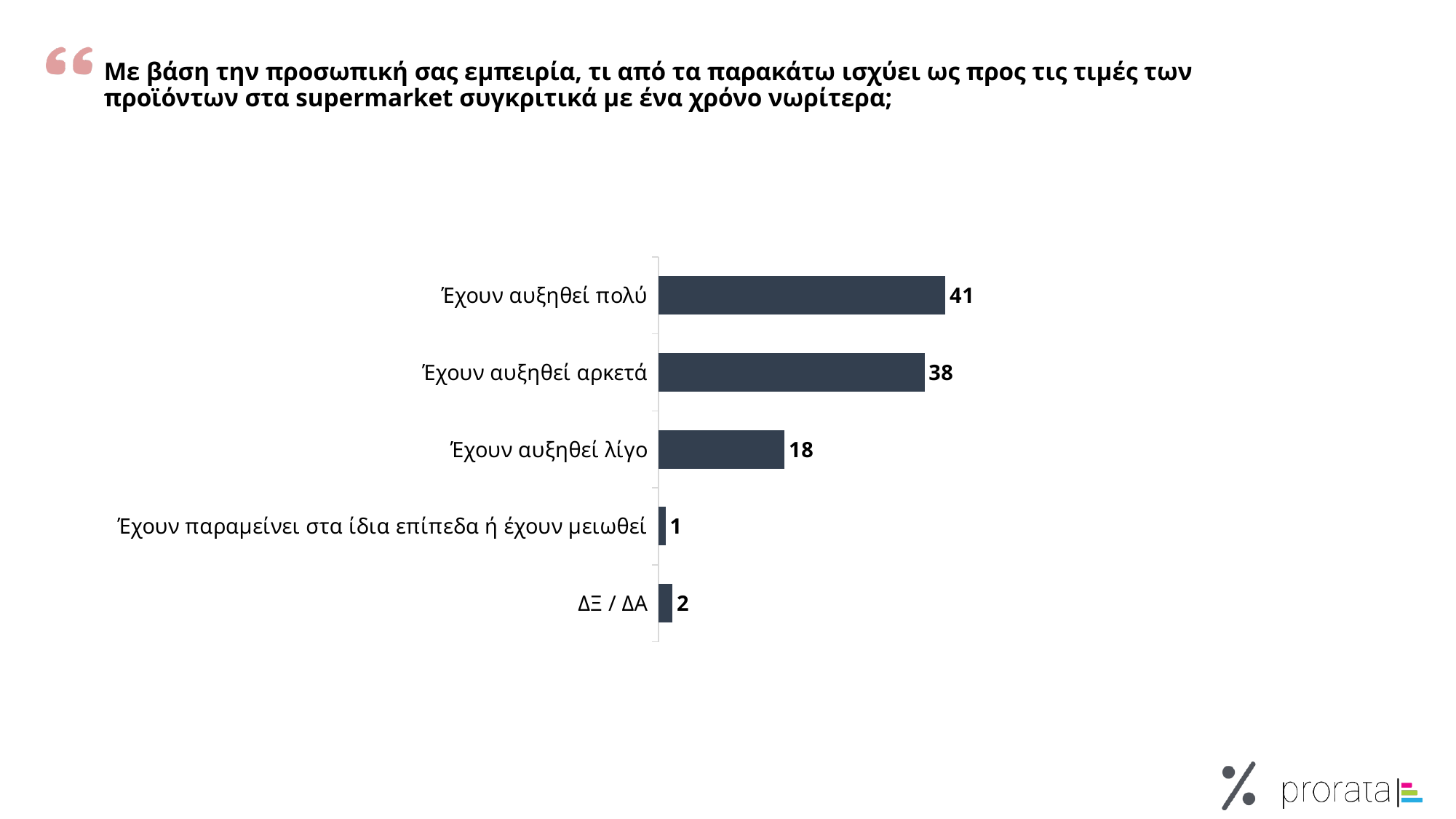
Which category has the lowest value? Έχουν παραμείνει στα ίδια επίπεδα ή έχουν μειωθεί Which category has the highest value? Έχουν αυξηθεί πολύ What is the value for "Έχουν αυξηθεί αρκετά"? 38 What is the difference between the values for "Έχουν αυξηθεί πολύ" and "Έχουν αυξηθεί αρκετά"? 3 What is the difference between the values for "Έχουν αυξηθεί αρκετά" and "Έχουν αυξηθεί λίγο"? 20 What is the value for "Έχουν αυξηθεί πολύ"? 41 How many categories are shown in the chart? 5 What kind of chart is shown on the slide? Bar chart What is the value for "ΔΞ / ΔΑ"? 2 What is the value for "Έχουν αυξηθεί λίγο"? 18 What is the value for "Έχουν παραμείνει στα ίδια επίπεδα ή έχουν μειωθεί"? 1 Which is larger, the value for "Έχουν αυξηθεί λίγο" or the value for "ΔΞ / ΔΑ"? Έχουν αυξηθεί λίγο